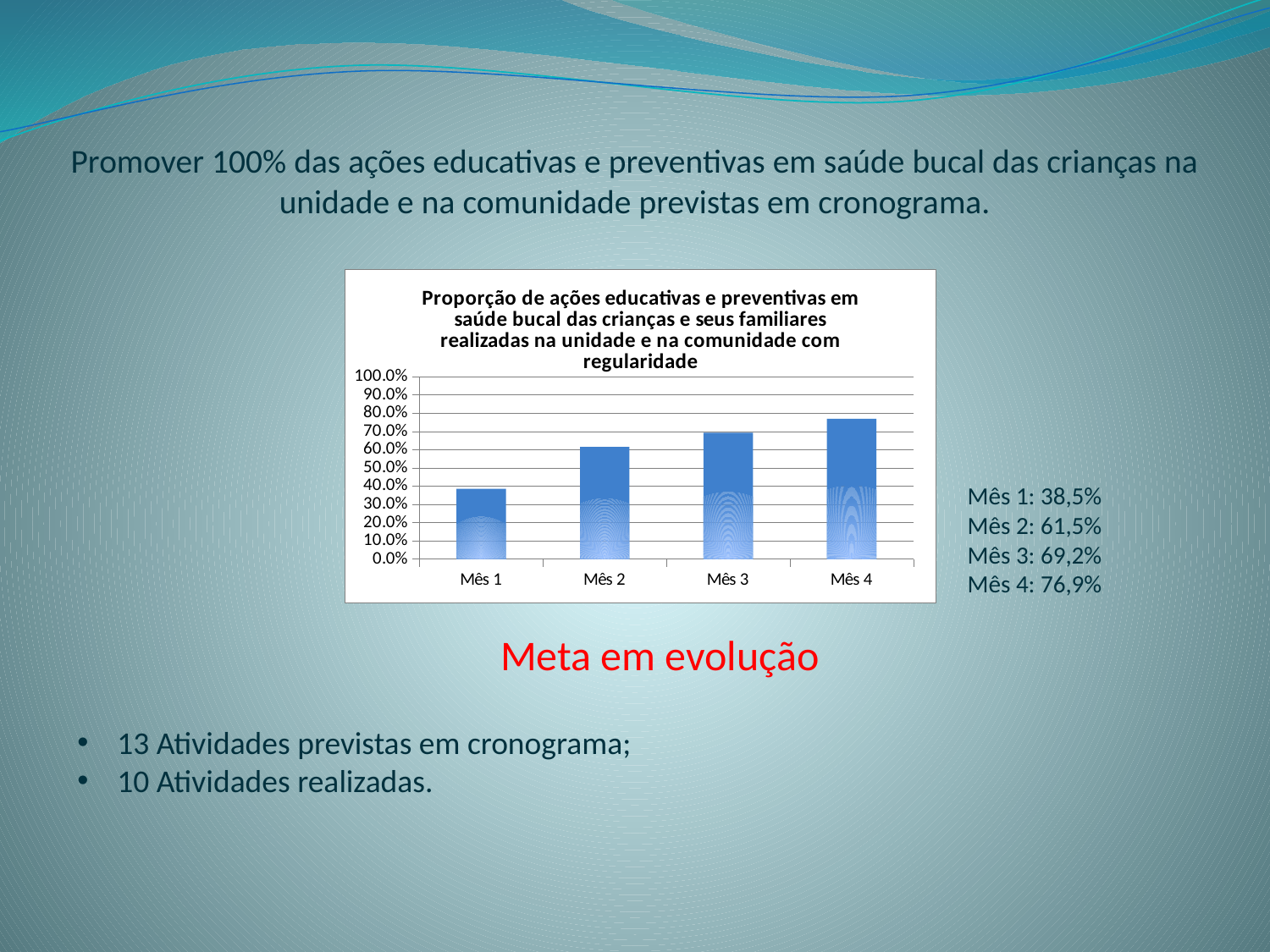
What is the value for Mês 1? 38,5% Which month has the highest value in the chart? Mês 4 What type of chart is shown on the slide? bar chart How many months (categories) are plotted in the chart? 4 What is the value for Mês 2? 61,5% Is the value for Mês 1 greater or less than 50.0%? less Which is larger, the value for Mês 2 or the value for Mês 3? Mês 3 Do the values rise or fall from Mês 1 to Mês 4? rise What is the difference between the values for Mês 4 and Mês 1? 38,4% What is the value for Mês 4? 76,9% What is the value for Mês 3? 69,2% Which month has the lowest value in the chart? Mês 1